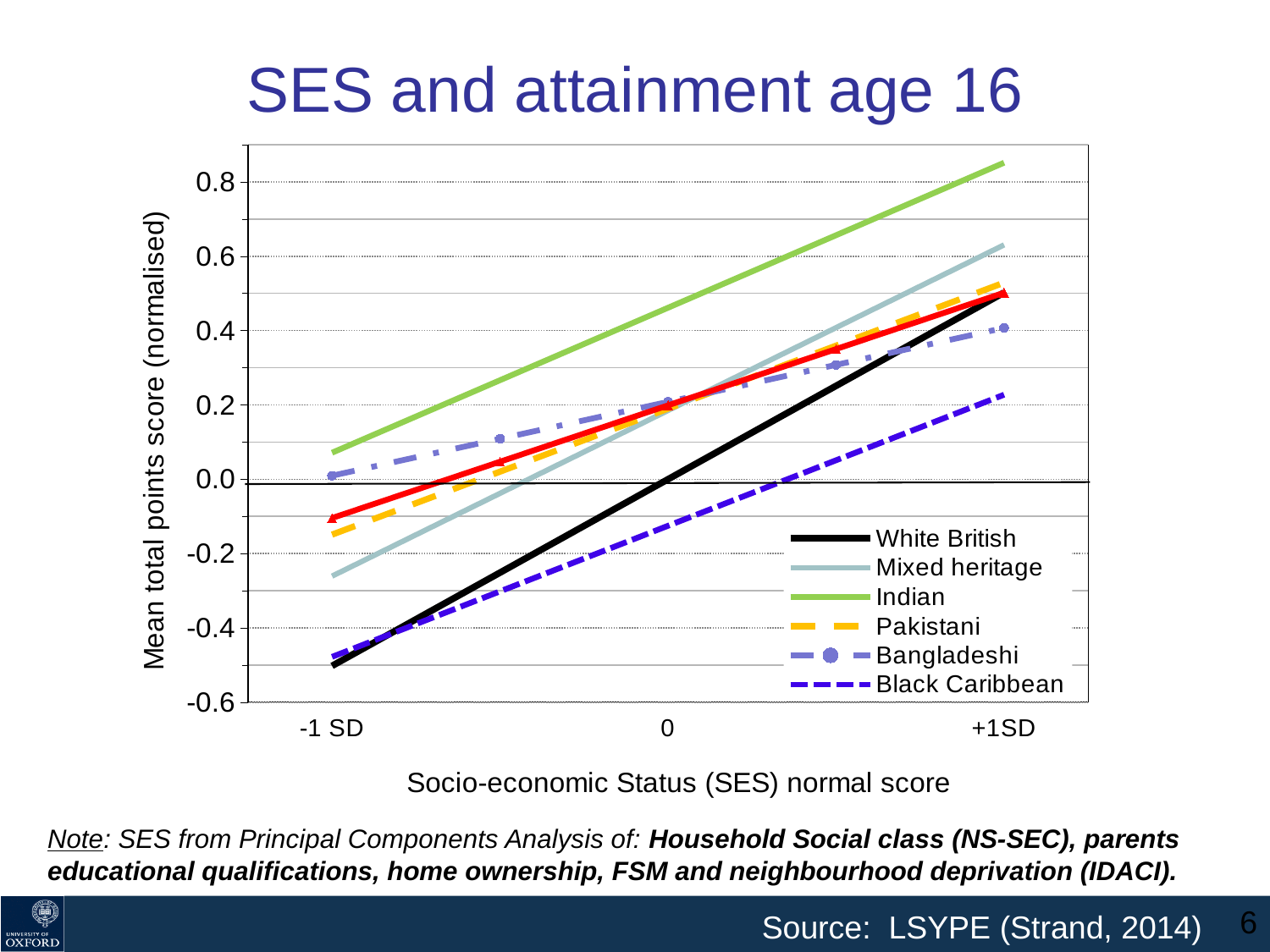
Is the value for Black Caribbean at +1SD greater or less than 0.4? less Which group has the highest mean total points score at +1SD? Indian Is the value for White British at -1 SD greater or less than -0.4? less Which group has the lowest mean total points score at +1SD? Black Caribbean What is the title of the chart? SES and attainment age 16 How many SES categories are labelled on the x axis? 3 Which group has the highest mean total points score at -1 SD? Indian How many series does the legend list? 6 At +1SD, which is larger: the value for Indian or the value for Mixed heritage? Indian What kind of chart is shown on the slide? line chart Is the value for Indian at +1SD greater or less than 0.8? greater Do the lines rise or fall as SES increases from -1 SD to +1SD? rise